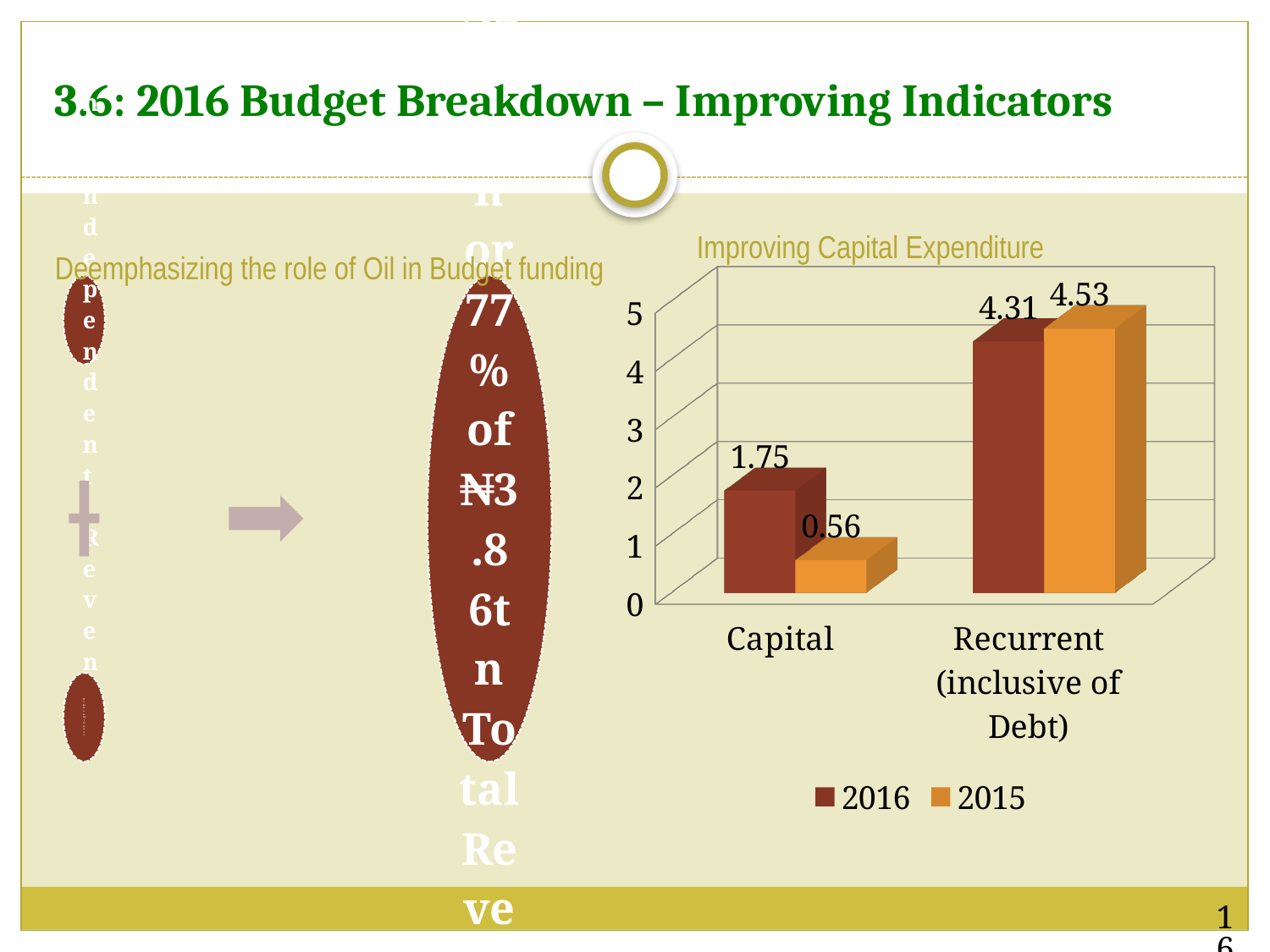
In the 'Improving Capital Expenditure' chart, what is the 2015 value for Recurrent (inclusive of Debt)? 4.53 In the 'Improving Capital Expenditure' chart, what is the 2016 value for Capital? 1.75 In the 'Improving Capital Expenditure' chart, what is the 2016 value for Recurrent (inclusive of Debt)? 4.31 In the 'Improving Capital Expenditure' chart, what is the 2015 value for Capital? 0.56 How many categories are shown on the x axis of the 'Improving Capital Expenditure' chart? 2 How many series does the legend of the 'Improving Capital Expenditure' chart list? 2 In the 'Improving Capital Expenditure' chart, which bar has the lowest value? 2015 Capital In the 'Improving Capital Expenditure' chart, what is the difference between the 2015 and 2016 values for Recurrent (inclusive of Debt)? 0.22 In the 'Improving Capital Expenditure' chart, which year has the larger value for Recurrent (inclusive of Debt), 2016 or 2015? 2015 In the 'Improving Capital Expenditure' chart, which year has the larger value for Capital, 2016 or 2015? 2016 What kind of chart is the 'Improving Capital Expenditure' chart? Bar chart In the 'Improving Capital Expenditure' chart, what is the difference between the 2016 and 2015 values for Capital? 1.19